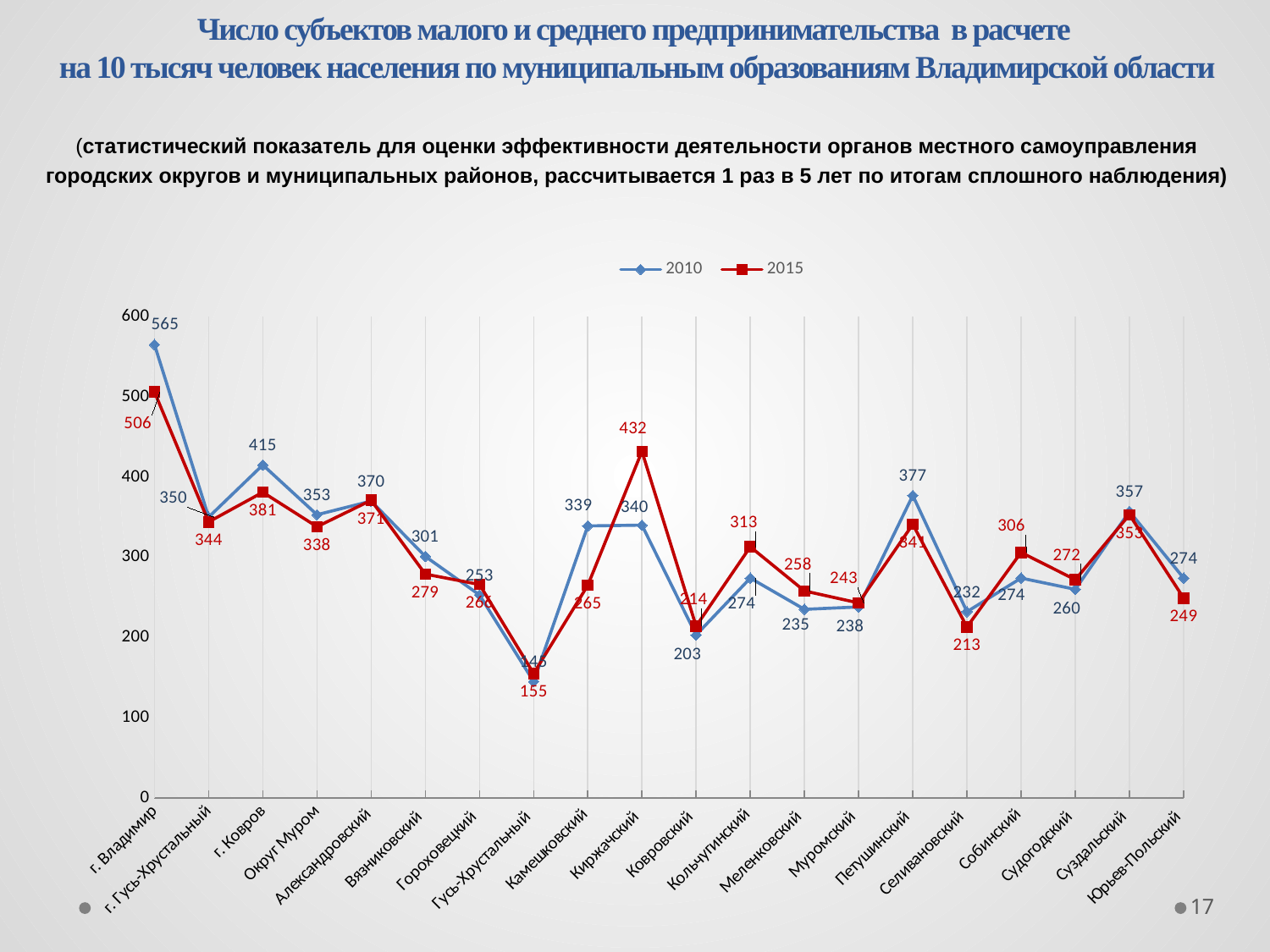
How many series does the legend list? 2 How many municipalities are plotted along the x axis? 20 Is the 2010 value for Петушинский greater or less than 300? greater Which series is drawn in red? 2015 What type of chart is shown on the slide? line chart What is the difference between the 2010 and 2015 values for г. Ковров? 34 Which municipality has the highest 2015 value? г. Владимир Which is larger for Камешковский: the 2010 value or the 2015 value? 2010 What is the 2015 value for Собинский? 306 What is the 2015 value for Киржачский? 432 Which municipality has the lowest 2015 value? Гусь-Хрустальный What is the 2010 value for г. Владимир? 565